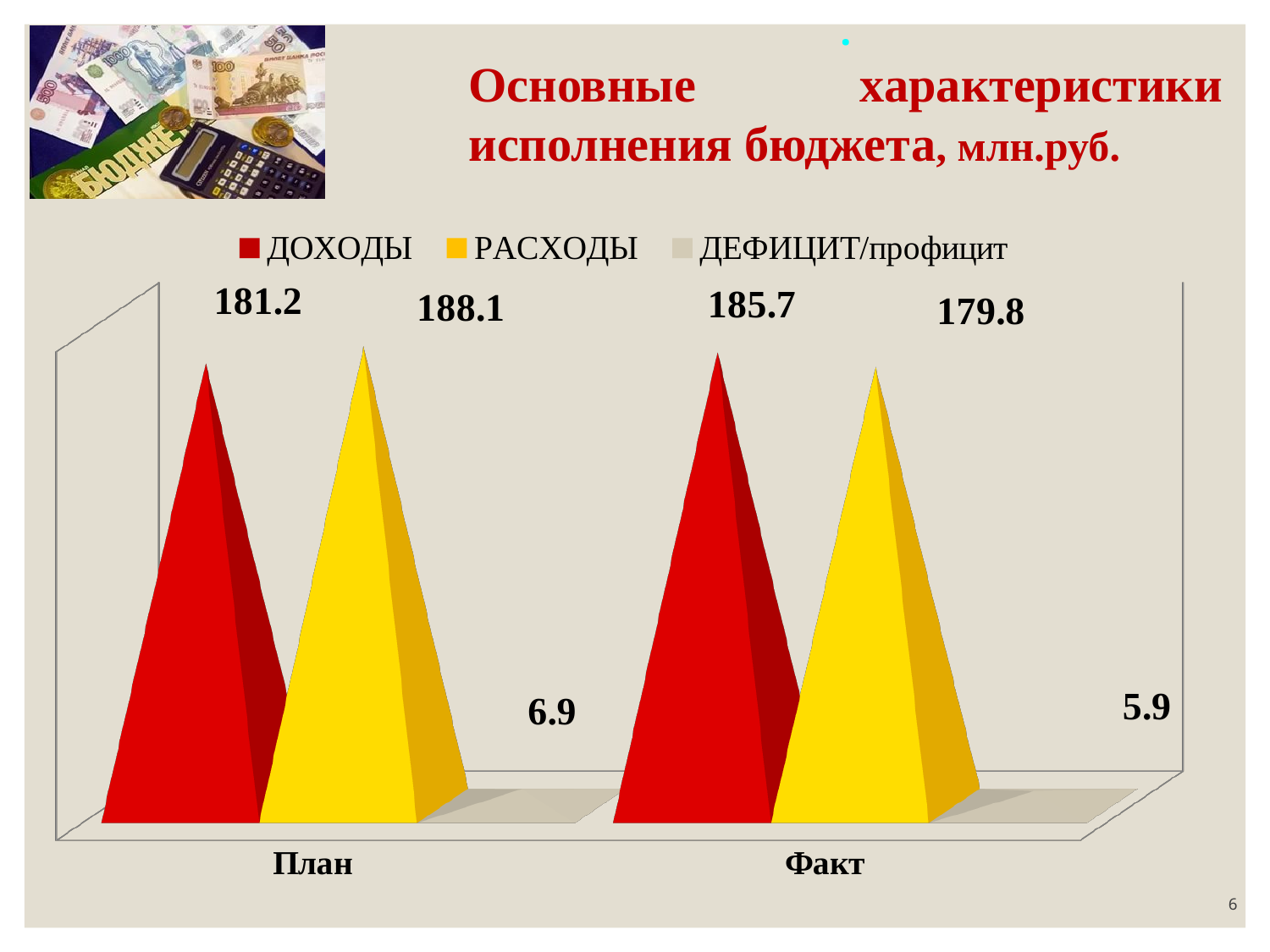
What is the difference between РАСХОДЫ and ДОХОДЫ for План? 6.9 How many categories are shown on the x axis? 2 Which series is shown in red? ДОХОДЫ What is the title of the chart? Основные характеристики исполнения бюджета, млн.руб. What is the value of ДОХОДЫ for План? 181.2 What kind of chart is shown on the slide? Bar chart What is the value of РАСХОДЫ for Факт? 179.8 What is the value of ДЕФИЦИТ/профицит for План? 6.9 Which category has the higher value for РАСХОДЫ, План or Факт? План How many series does the legend list? 3 What is the value of ДОХОДЫ for Факт? 185.7 What is the difference between ДОХОДЫ and РАСХОДЫ for Факт? 5.9